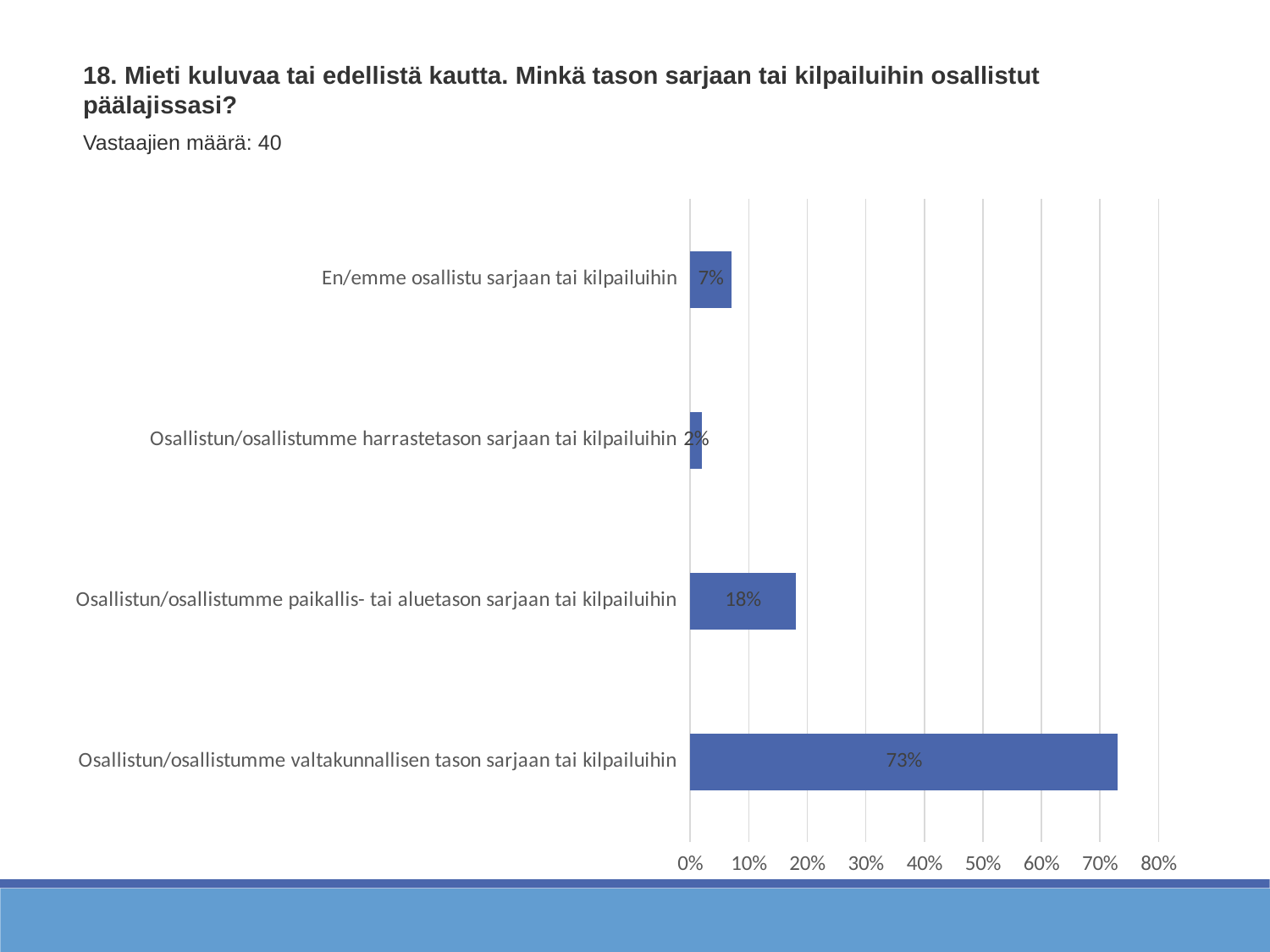
Which category has the highest value? Osallistun/osallistumme valtakunnallisen tason sarjaan tai kilpailuihin How many categories are shown in the chart? 4 Which category has the lowest value? Osallistun/osallistumme harrastetason sarjaan tai kilpailuihin What is the value for "Osallistun/osallistumme paikallis- tai aluetason sarjaan tai kilpailuihin"? 18% What kind of chart is shown on the slide? bar chart What is the value for "Osallistun/osallistumme valtakunnallisen tason sarjaan tai kilpailuihin"? 73% Which is larger: the value for "En/emme osallistu sarjaan tai kilpailuihin" or for "Osallistun/osallistumme paikallis- tai aluetason sarjaan tai kilpailuihin"? Osallistun/osallistumme paikallis- tai aluetason sarjaan tai kilpailuihin What is the number of respondents (Vastaajien määrä) stated on the slide? 40 What is the difference between the values for the valtakunnallisen tason category and the paikallis- tai aluetason category? 55% What is the value for "Osallistun/osallistumme harrastetason sarjaan tai kilpailuihin"? 2% What is the value for "En/emme osallistu sarjaan tai kilpailuihin"? 7% Is the value for "Osallistun/osallistumme valtakunnallisen tason sarjaan tai kilpailuihin" greater or less than 50%? greater